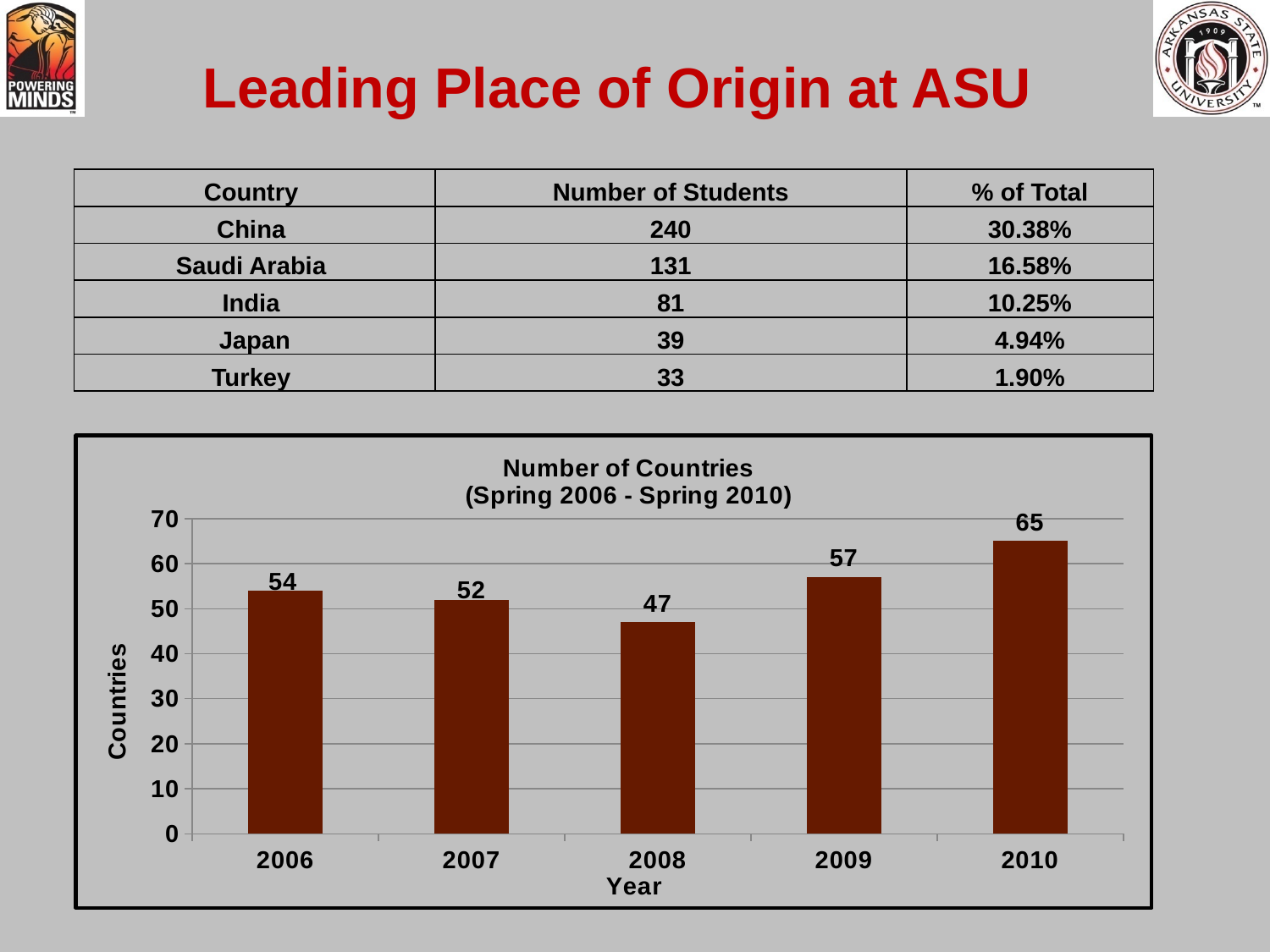
What is the value for 2010 in the Number of Countries chart? 65 Is the value for 2007 in the chart greater or less than 60? less What is the difference between the number of countries in 2009 and in 2007? 5 How many years are shown on the x axis of the Number of Countries chart? 5 What is the label of the y axis of the chart? Countries What is the value for 2006 in the Number of Countries chart? 54 Which year has the highest number of countries in the chart? 2010 What kind of chart is shown on the slide? bar chart What is the difference between the number of countries in 2010 and in 2008? 18 Which year has a larger value in the chart, 2006 or 2009? 2009 Which year has the lowest number of countries in the chart? 2008 What is the value for 2008 in the Number of Countries chart? 47